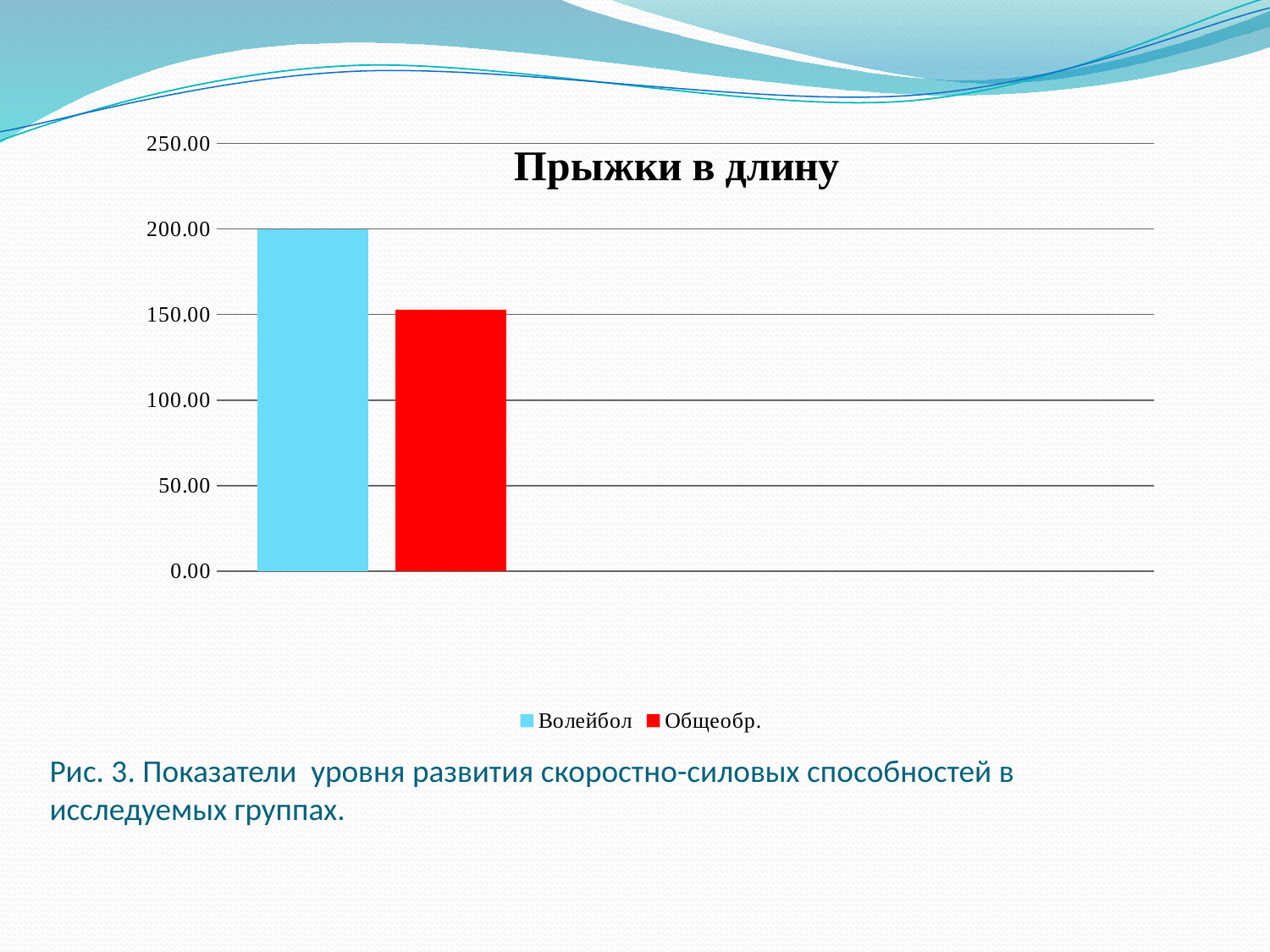
Which series has the lowest bar? Общеобр. How many bars are plotted in the chart? 2 What kind of chart is shown on the slide? bar chart What value does the Волейбол bar reach on the axis? 200.00 What colour is the bar for Общеобр.? red How many series does the legend list? 2 Is the value for Волейбол greater or less than 150.00? greater Is the value for Общеобр. greater or less than 200.00? less What is the title of the chart? Прыжки в длину Which is larger, the value for Волейбол or the value for Общеобр.? Волейбол Which series has the highest bar? Волейбол